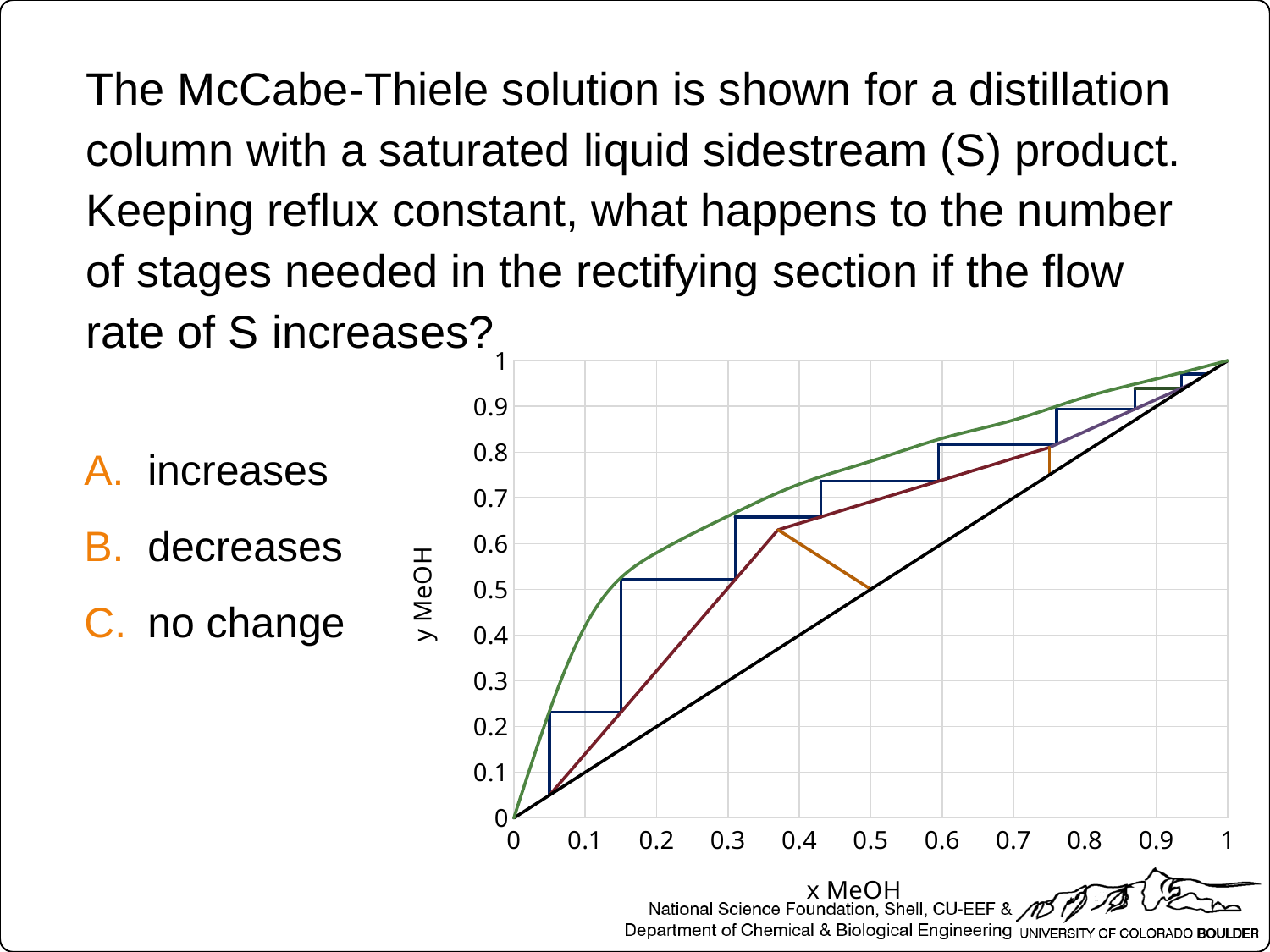
Does the green curve rise or fall as x MeOH increases from 0 to 1? rises What is the label of the x axis of the chart? x MeOH What is the highest tick value shown on the x axis? 1 Is the value of the green curve at x MeOH = 0.1 greater or less than 0.3? greater What is the spacing between consecutive tick labels on the y axis? 0.1 Is the value of the green curve at x MeOH = 0.9 greater or less than 0.9? greater Is the value of the green curve at x MeOH = 0.2 greater or less than 0.5? greater How many tick labels are shown on the x axis? 11 What is the label of the y axis of the chart? y MeOH What is the highest tick value shown on the y axis? 1 What kind of chart is shown on the slide? line chart